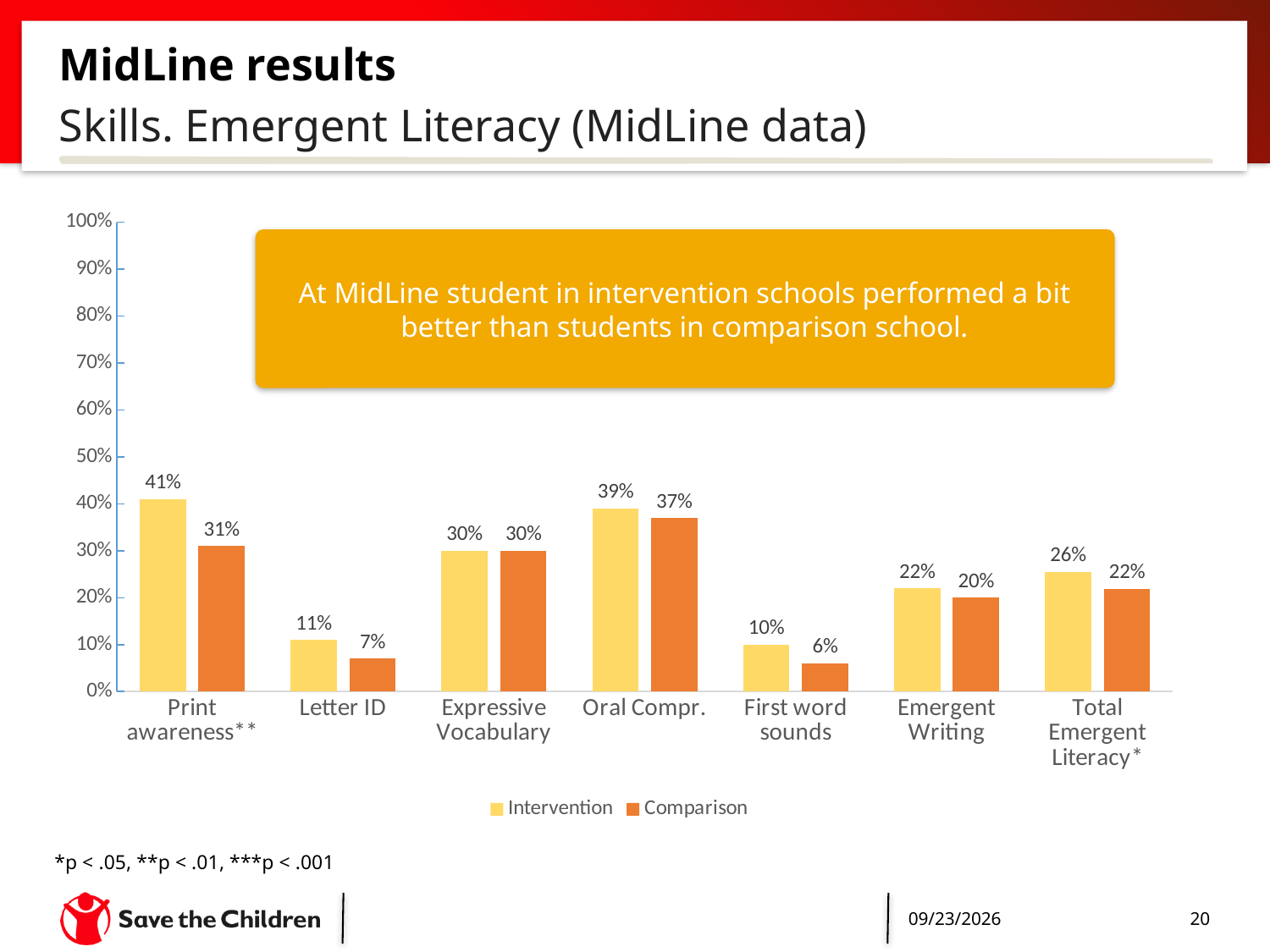
What is the Intervention value for Print awareness**? 41% What is the difference between the Intervention and Comparison values for Print awareness**? 10% What kind of chart is shown on the slide? Bar chart Which category has the lowest Comparison value? First word sounds What is the difference between the Intervention and Comparison values for Letter ID? 4% Which series is shown in orange in the legend? Comparison What is the Comparison value for First word sounds? 6% How many series does the legend list? 2 What is the Intervention value for Total Emergent Literacy*? 26% How many categories are shown on the x axis? 7 Which category has the highest Intervention value? Print awareness** Which is larger for Oral Compr., the Intervention value or the Comparison value? Intervention